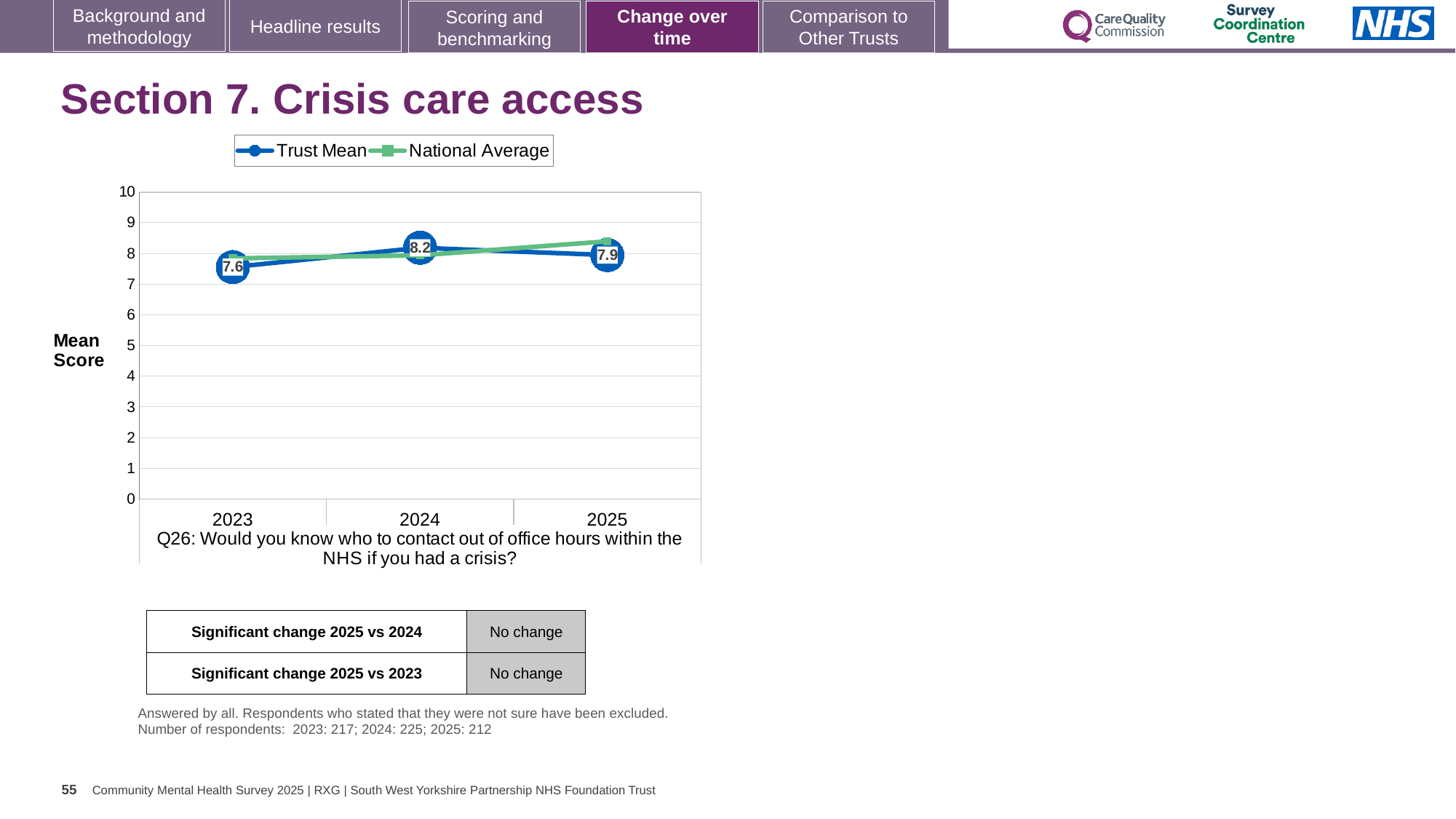
Does the Trust Mean score rise or fall from 2024 to 2025? fall How many years are plotted on the x axis? 3 In which year was the Trust Mean score lowest? 2023 How many series does the legend list? 2 What kind of chart is shown on the slide? line chart Which year has the larger Trust Mean score, 2023 or 2025? 2025 What is the Trust Mean score for 2024? 8.2 What is the Trust Mean score for 2023? 7.6 Is the National Average value for 2025 greater or less than 8? greater What is the Trust Mean score for 2025? 7.9 In which year was the Trust Mean score highest? 2024 What is the difference between the Trust Mean scores for 2024 and 2023? 0.6